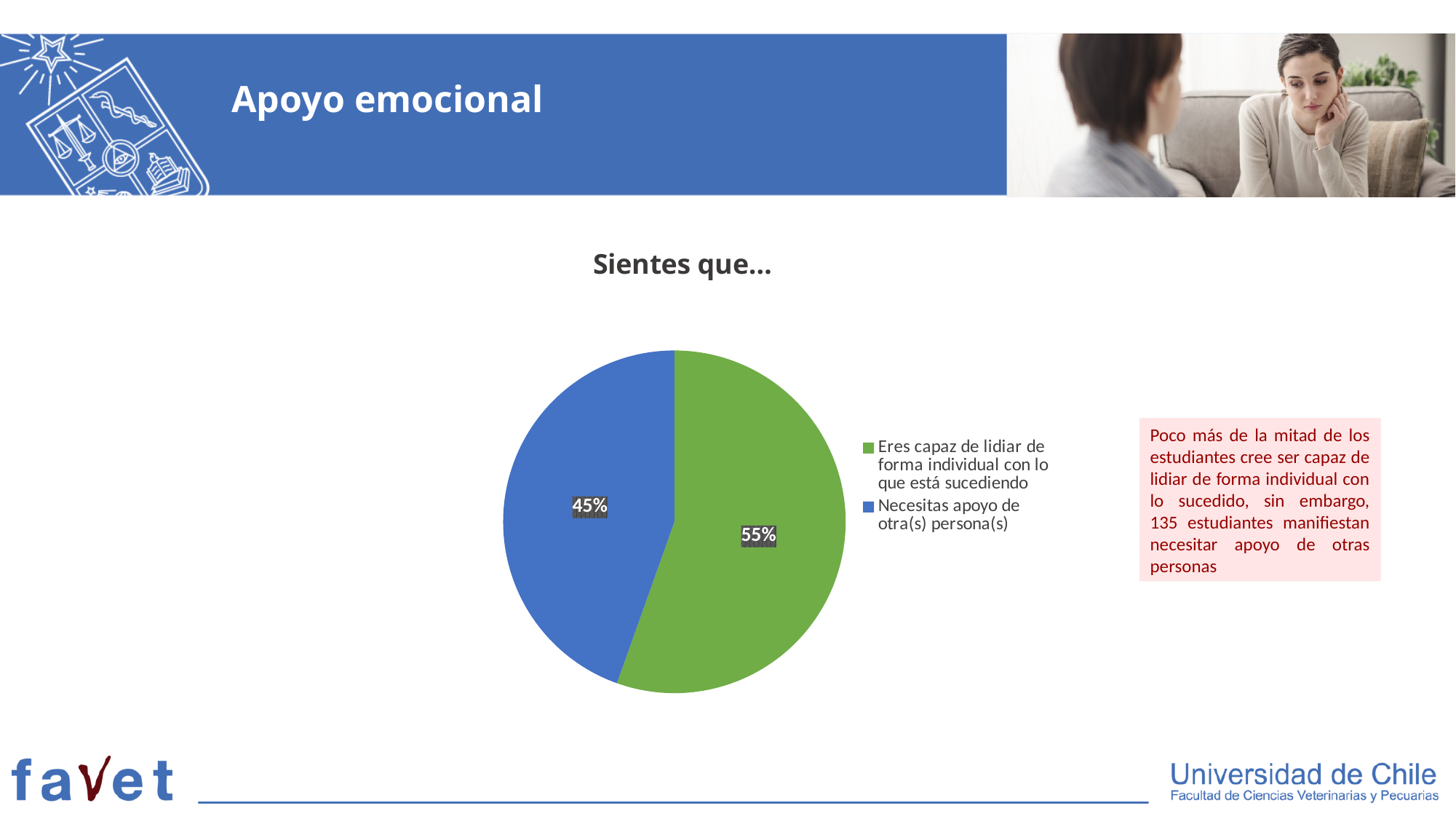
What percentage of the pie corresponds to "Eres capaz de lidiar de forma individual con lo que está sucediendo"? 55% What is the chart's title? Sientes que... What is the difference in percentage points between the two slices of the pie chart? 10 Which slice is the smallest in the pie chart? Necesitas apoyo de otra(s) persona(s) What kind of chart is shown on the slide? pie chart What share of the pie does the green slice represent? 55% Which is larger: the share for "Eres capaz de lidiar de forma individual con lo que está sucediendo" or for "Necesitas apoyo de otra(s) persona(s)"? Eres capaz de lidiar de forma individual con lo que está sucediendo What colour is the slice for "Necesitas apoyo de otra(s) persona(s)"? blue How many slices does the pie chart have? 2 Which slice is the largest in the pie chart? Eres capaz de lidiar de forma individual con lo que está sucediendo How many entries does the legend list? 2 What percentage of the pie corresponds to "Necesitas apoyo de otra(s) persona(s)"? 45%